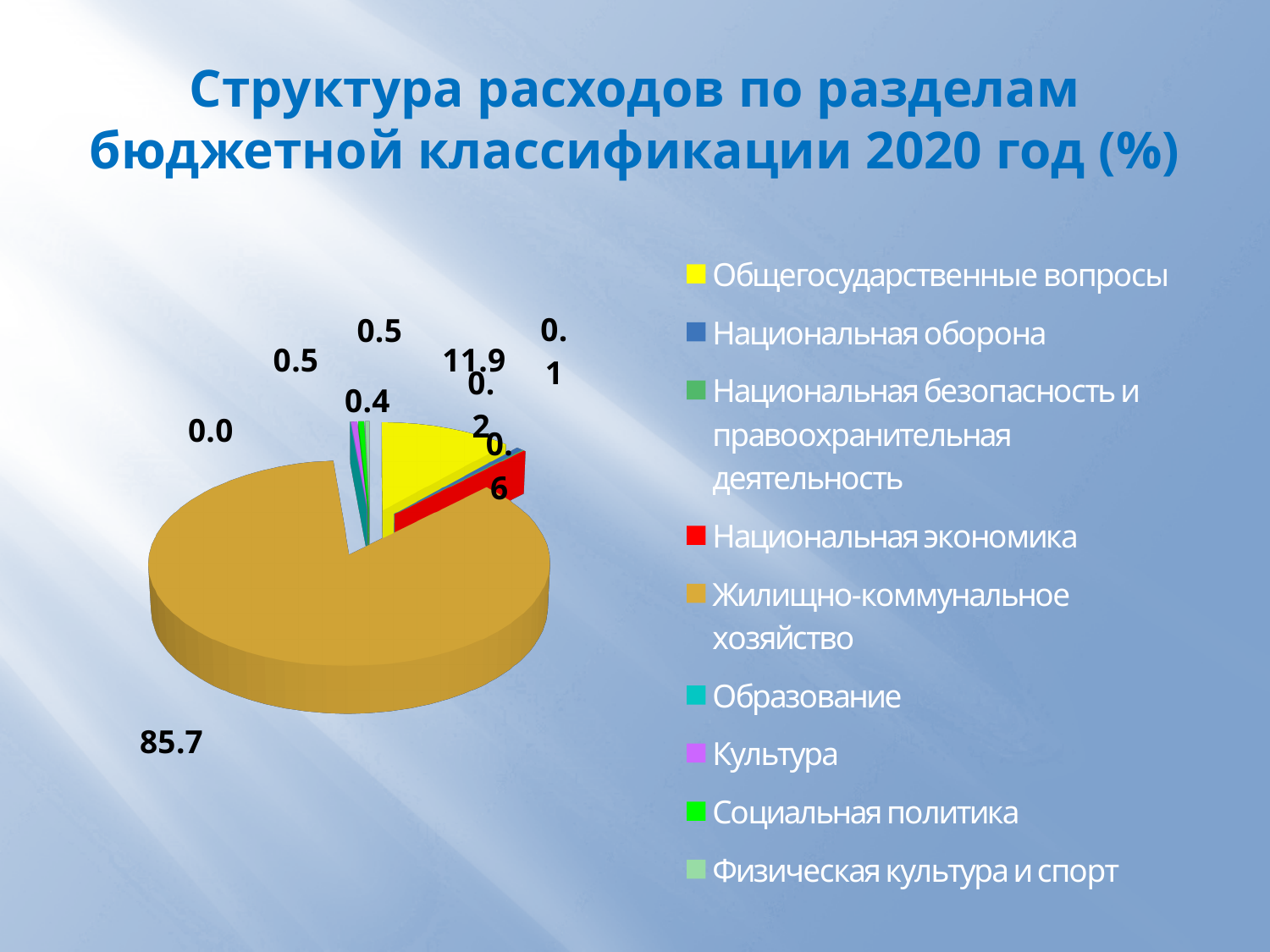
Is the value for Общегосударственные вопросы greater or less than 50? less Which category has the largest slice in the pie chart? Жилищно-коммунальное хозяйство What is the title of the chart on the slide? Структура расходов по разделам бюджетной классификации 2020 год (%) What is the difference between the values for Жилищно-коммунальное хозяйство and Общегосударственные вопросы? 73.8 How many data labels are printed around the pie chart? 9 How many categories does the legend of the pie chart list? 9 What kind of chart is shown on the slide? pie chart What value is shown for Жилищно-коммунальное хозяйство? 85.7 What value is shown for Национальная экономика? 0.2 What colour represents Национальная экономика in the legend? red What value is shown for Общегосударственные вопросы? 11.9 Which is larger, the slice for Общегосударственные вопросы or the slice for Жилищно-коммунальное хозяйство? Жилищно-коммунальное хозяйство